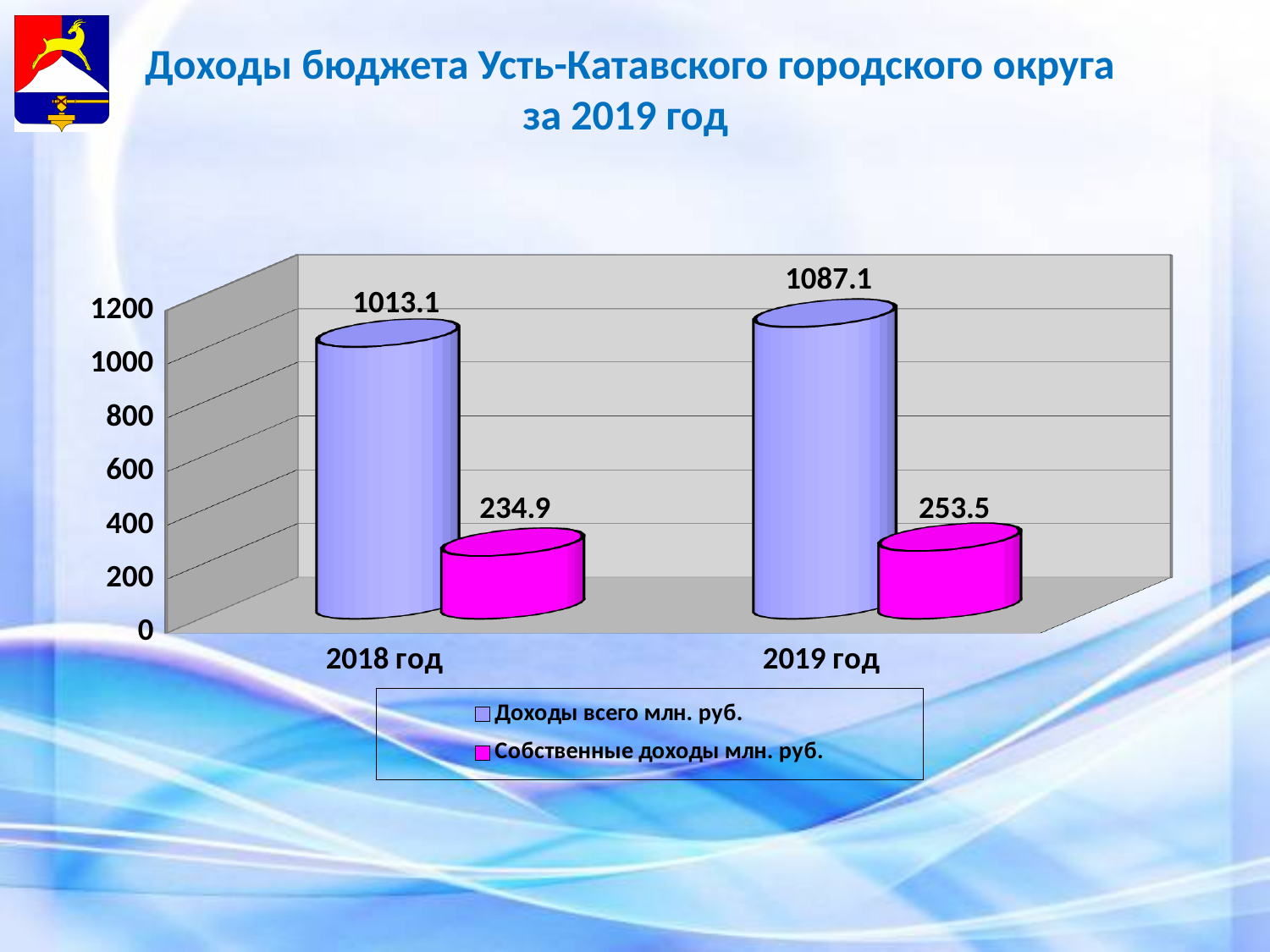
Is the value for "Доходы всего млн. руб." in 2019 год greater or less than 1000? greater Which year has the lower value for "Собственные доходы млн. руб."? 2018 год Which year has the higher value for "Доходы всего млн. руб."? 2019 год What kind of chart is shown on the slide? bar chart What is the difference between "Собственные доходы млн. руб." in 2019 год and 2018 год? 18.6 How many series does the legend list? 2 Do the values for "Доходы всего млн. руб." rise or fall from 2018 год to 2019 год? rise What is the value of "Собственные доходы млн. руб." for 2019 год? 253.5 How many years (categories) are shown on the x axis? 2 What is the value of "Доходы всего млн. руб." for 2018 год? 1013.1 What is the value of "Собственные доходы млн. руб." for 2018 год? 234.9 What is the difference between "Доходы всего млн. руб." in 2019 год and 2018 год? 74.0